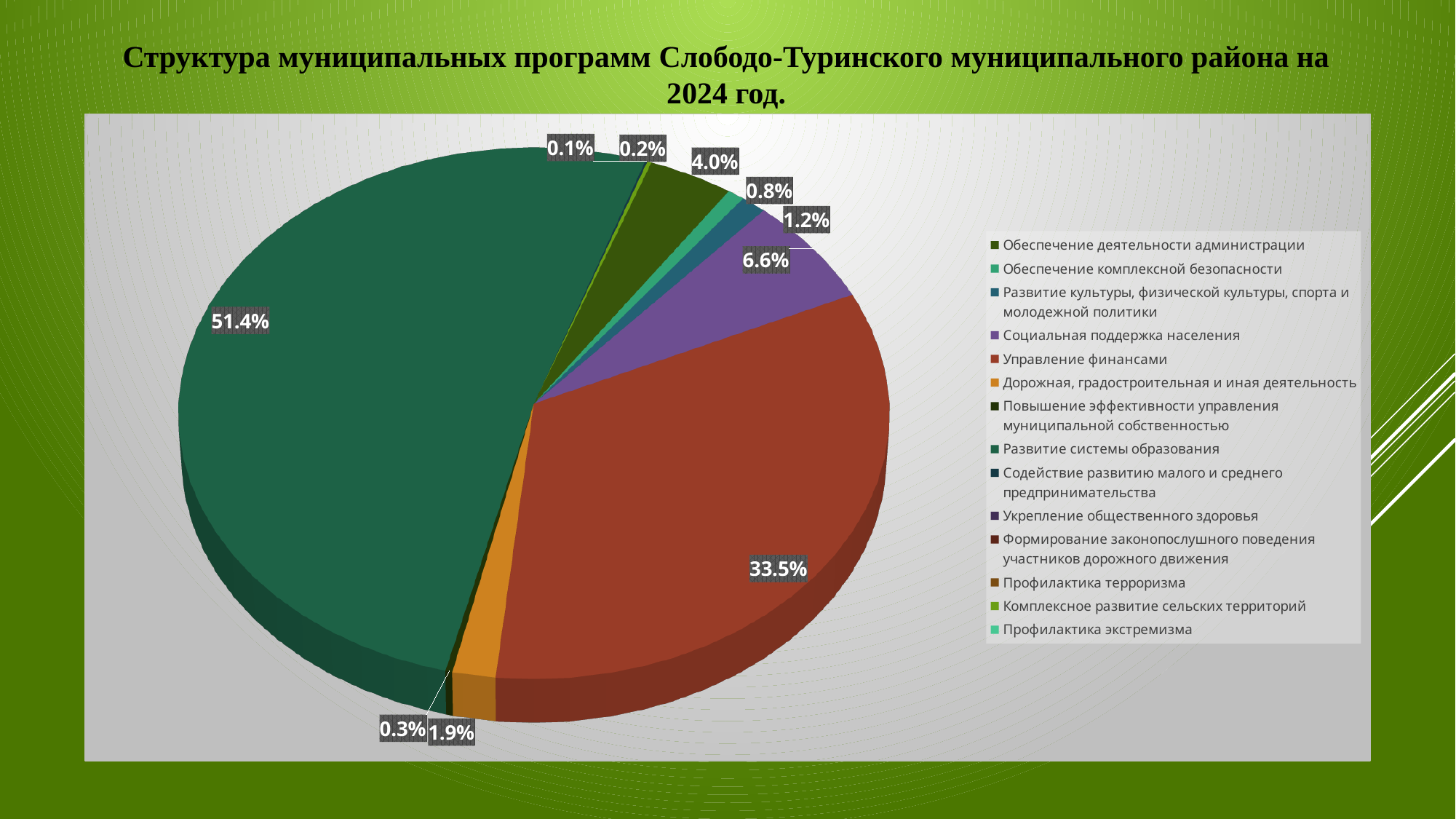
What share does Социальная поддержка населения have? 6.6% What share does Обеспечение комплексной безопасности have? 0.8% What is the difference in percentage points between the shares of Развитие системы образования and Управление финансами? 17.9 What share does Управление финансами have in the pie chart? 33.5% How many entries does the legend of the pie chart list? 14 What is the share of the largest slice in the pie chart? 51.4% What share does Обеспечение деятельности администрации have? 4.0% What share does Дорожная, градостроительная и иная деятельность have? 1.9% Which program has the largest share of the pie? Развитие системы образования What is the smallest percentage label shown on the pie chart? 0.1% Which has a larger share: Социальная поддержка населения or Обеспечение деятельности администрации? Социальная поддержка населения What kind of chart is shown on the slide? Pie chart